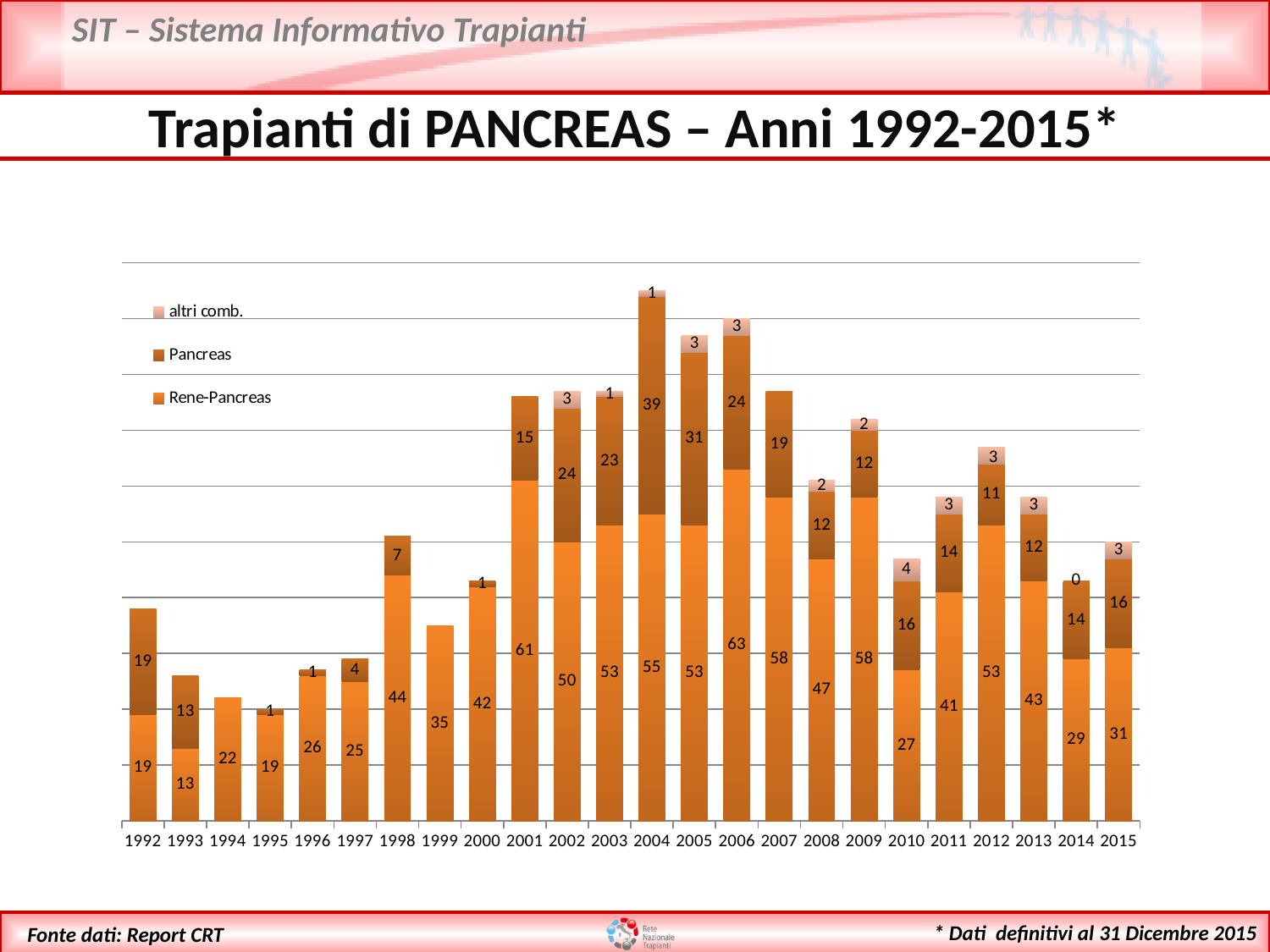
How many series does the legend list? 3 How many years are shown on the x axis? 24 What type of chart is shown on the slide? stacked bar chart What is the Rene-Pancreas value for 2006? 63 What is the total of the stacked bar for 2015? 50 What is the title of the chart? Trapianti di PANCREAS – Anni 1992-2015* What is the difference between the Rene-Pancreas values for 2001 and 2000? 19 What is the altri comb. value for 2010? 4 Which year has the lowest Rene-Pancreas value? 1993 Which year has the highest Rene-Pancreas value? 2006 What is the Pancreas value for 2004? 39 Which is larger, the Pancreas value for 2005 or for 2007? 2005